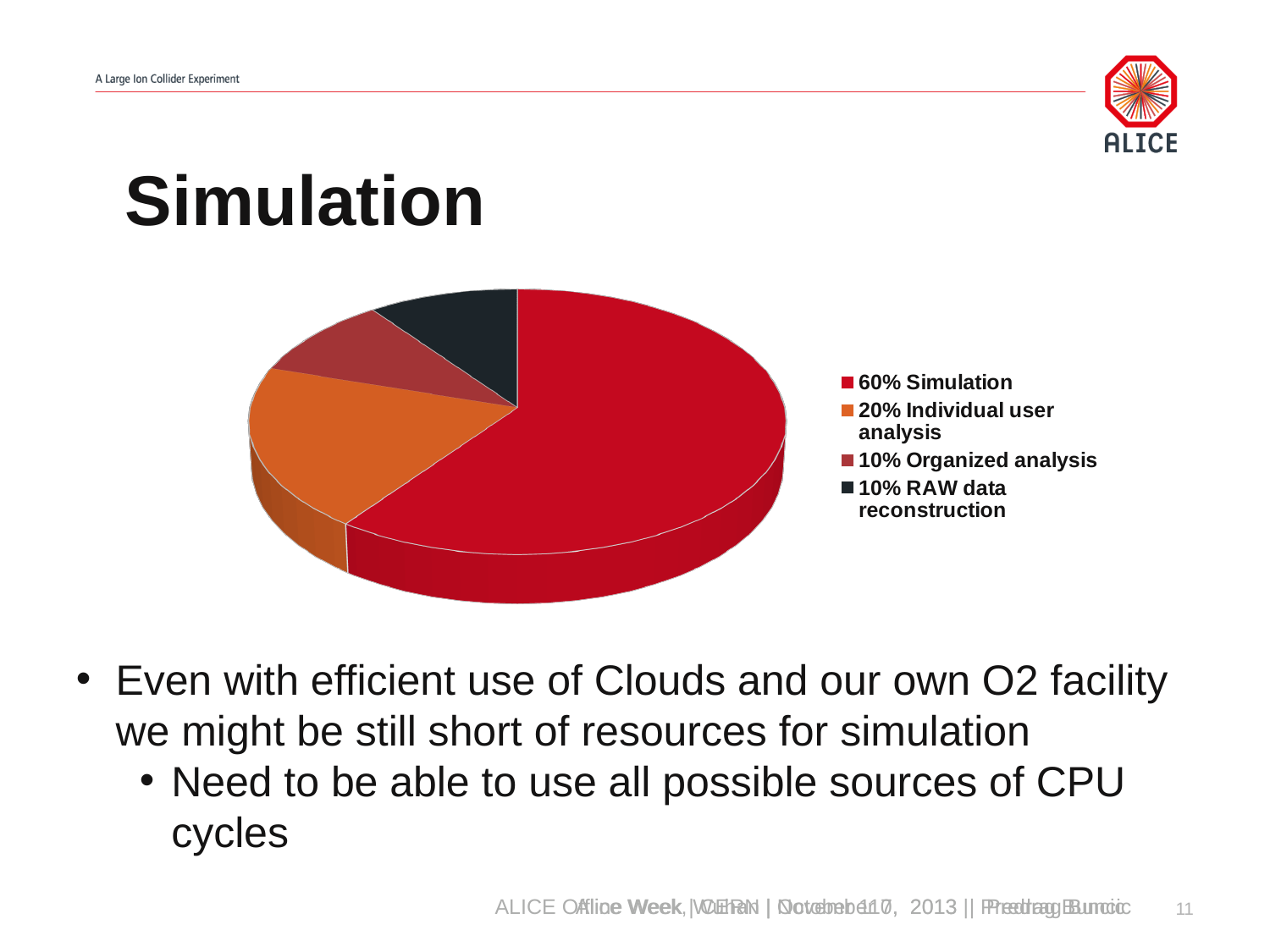
What share of the pie does Organized analysis take? 10% What colour is the Simulation slice in the pie chart? red Which is larger, the slice for Simulation or the slice for Individual user analysis? Simulation How many entries does the legend of the pie chart list? 4 How many slices does the pie chart have? 4 What is the difference in percentage points between the Simulation slice and the Individual user analysis slice? 40% What kind of chart is shown on the slide? pie chart Which category has the largest slice of the pie? Simulation What share of the pie does Individual user analysis take? 20% What is the combined share of Organized analysis and RAW data reconstruction? 20% What share of the pie does RAW data reconstruction take? 10%